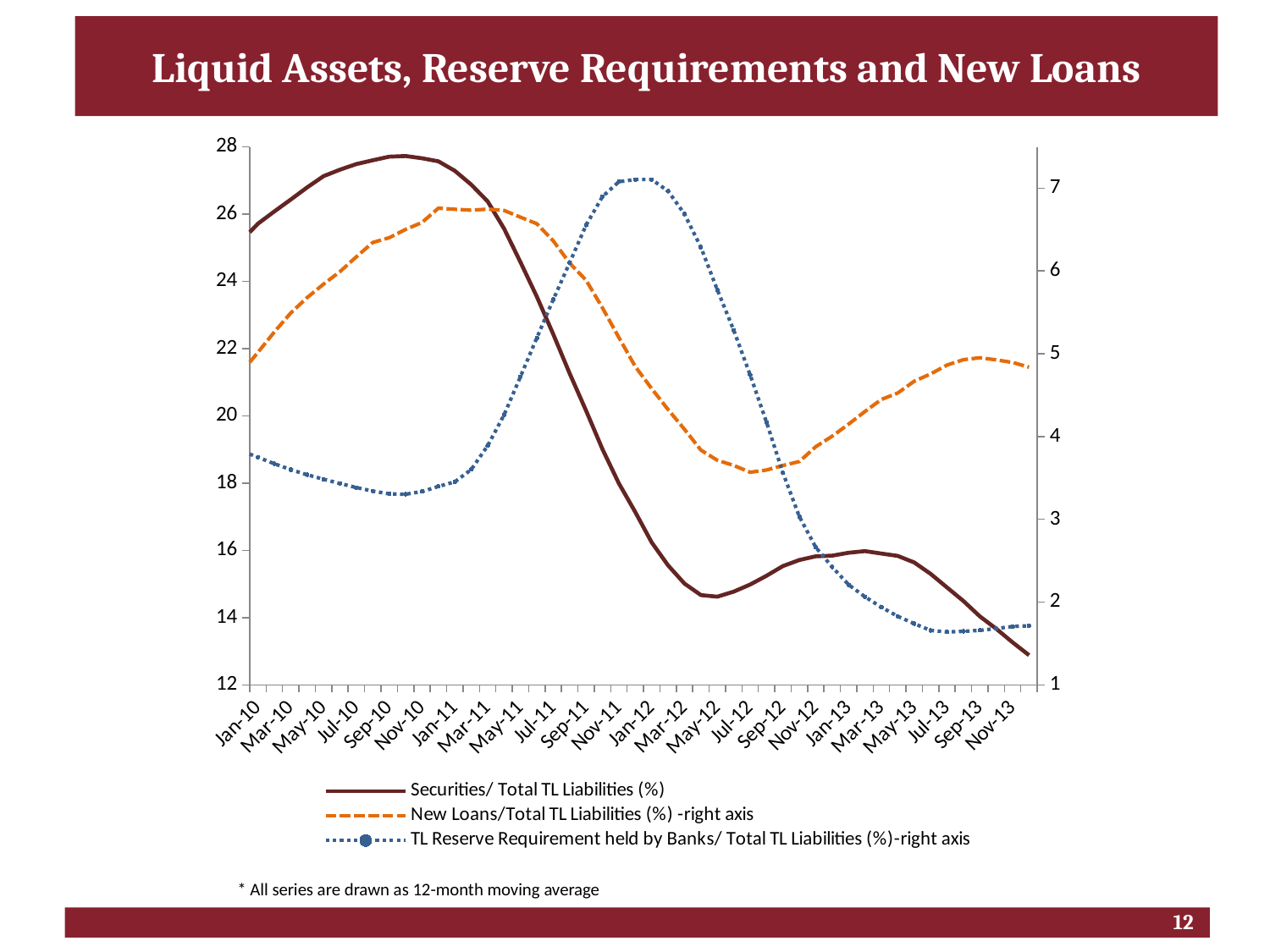
Is the value of TL Reserve Requirement held by Banks/ Total TL Liabilities (%) at Nov-13 greater or less than 2 on the right axis? less Which series is plotted on the left axis? Securities/ Total TL Liabilities (%) Does the TL Reserve Requirement held by Banks/ Total TL Liabilities (%) series rise or fall from Jan-12 to Jul-13? fall What is the title of the slide? Liquid Assets, Reserve Requirements and New Loans Is the value of Securities/ Total TL Liabilities (%) at Jan-10 greater or less than 24? greater Is the value of New Loans/Total TL Liabilities (%) at Jul-12 greater or less than 4 on the right axis? less Does the Securities/ Total TL Liabilities (%) series rise or fall overall from Jan-10 to Nov-13? fall According to the footnote, how are all series drawn? 12-month moving average How many series does the legend list? 3 What kind of chart is shown on the slide? line chart